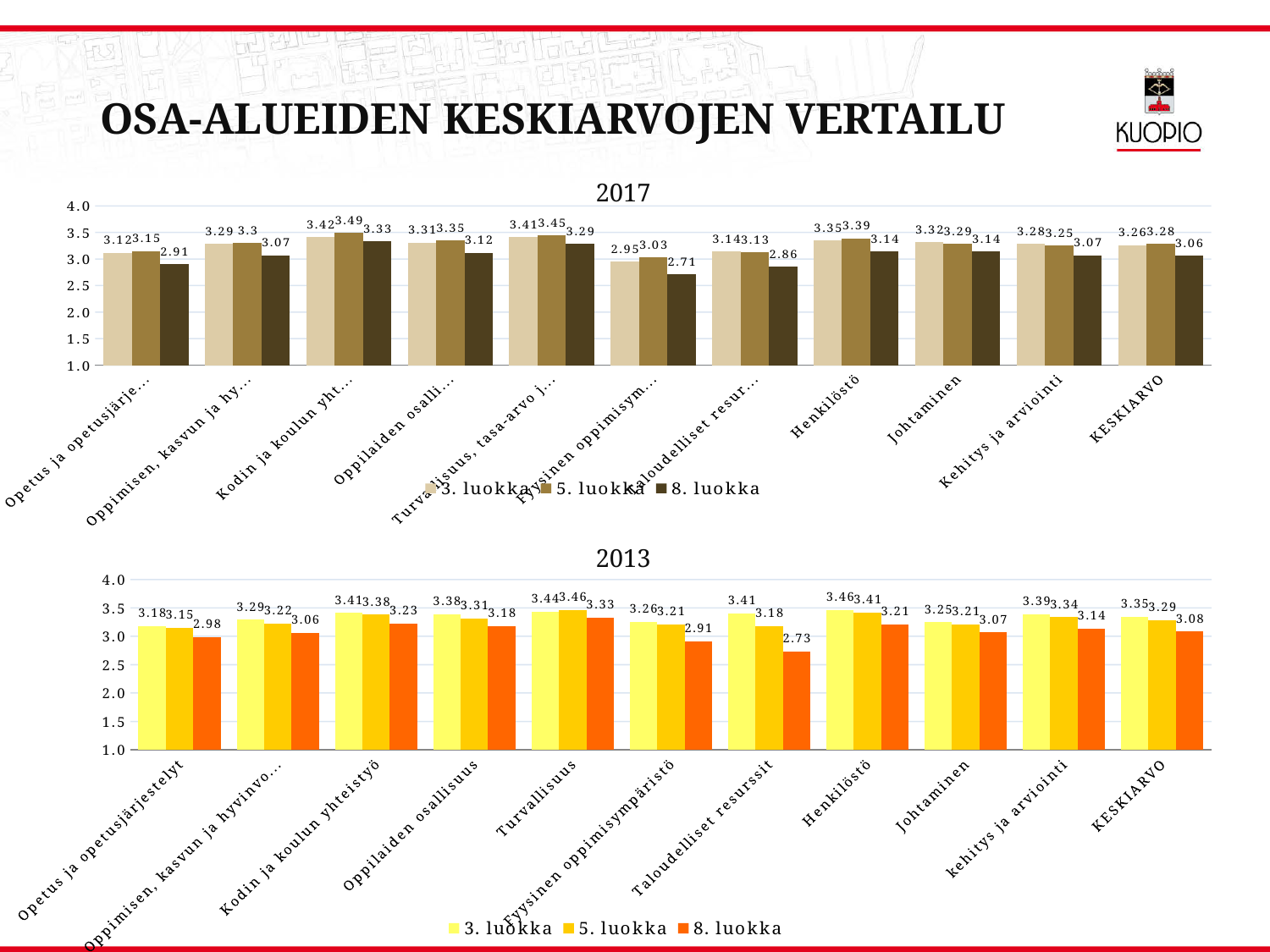
How many categories are shown on the x axis of the 2013 chart? 11 In the 2017 chart, what is the value for 8. luokka in the Henkilöstö category? 3.14 In the 2017 chart, what is the difference between the 5. luokka and 8. luokka values for KESKIARVO? 0.22 In the 2013 chart, is the 8. luokka value for Fyysinen oppimisympäristö greater or less than 3.0? less In the 2013 chart, which category has the lowest value for 8. luokka? Taloudelliset resurssit In the 2013 chart, what is the difference between the 3. luokka and 8. luokka values for Taloudelliset resurssit? 0.68 In the 2013 chart, which category has the highest value for 3. luokka? Henkilöstö How many series does the legend of the 2013 chart list? 3 In the 2017 chart, which is larger for Johtaminen: the 3. luokka value or the 5. luokka value? 3. luokka In the 2013 chart, what is the KESKIARVO value for 5. luokka? 3.29 What type of chart is the 2017 chart? bar chart In the 2013 chart, what is the value for 3. luokka in the Taloudelliset resurssit category? 3.41